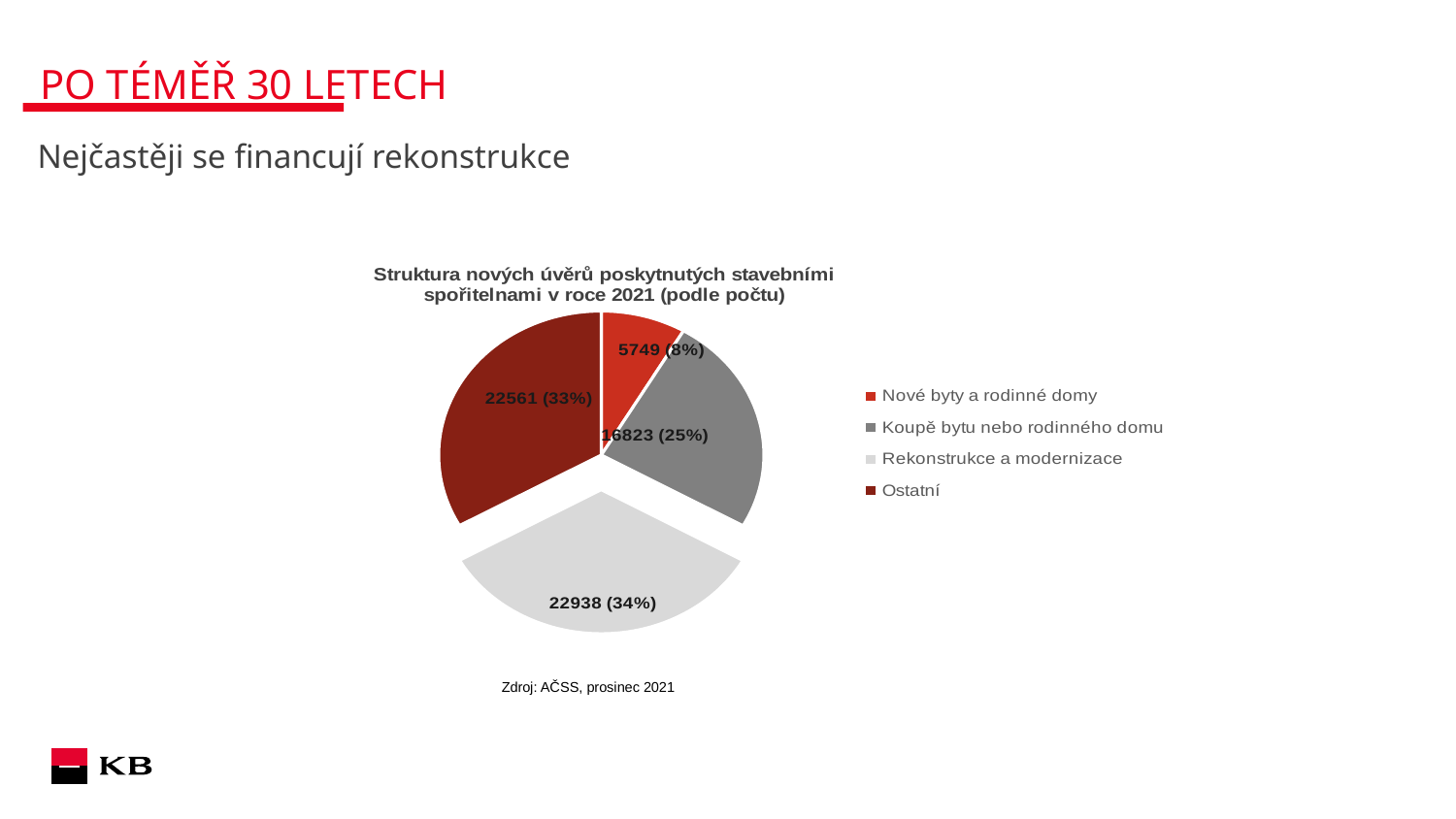
How many slices does the pie chart have? 4 What is the value for Ostatní? 22561 (33%) What is the title of the chart? Struktura nových úvěrů poskytnutých stavebními spořitelnami v roce 2021 (podle počtu) Which category has the smallest share of the pie? Nové byty a rodinné domy Which category has the largest share of the pie? Rekonstrukce a modernizace What share of the pie does Ostatní represent? 33% What kind of chart is shown on the slide? pie chart How many entries does the legend list? 4 What is the value for Rekonstrukce a modernizace? 22938 (34%) What is the difference between the values for Rekonstrukce a modernizace and Koupě bytu nebo rodinného domu? 6115 What is the value for Koupě bytu nebo rodinného domu? 16823 (25%) What is the value for Nové byty a rodinné domy? 5749 (8%)